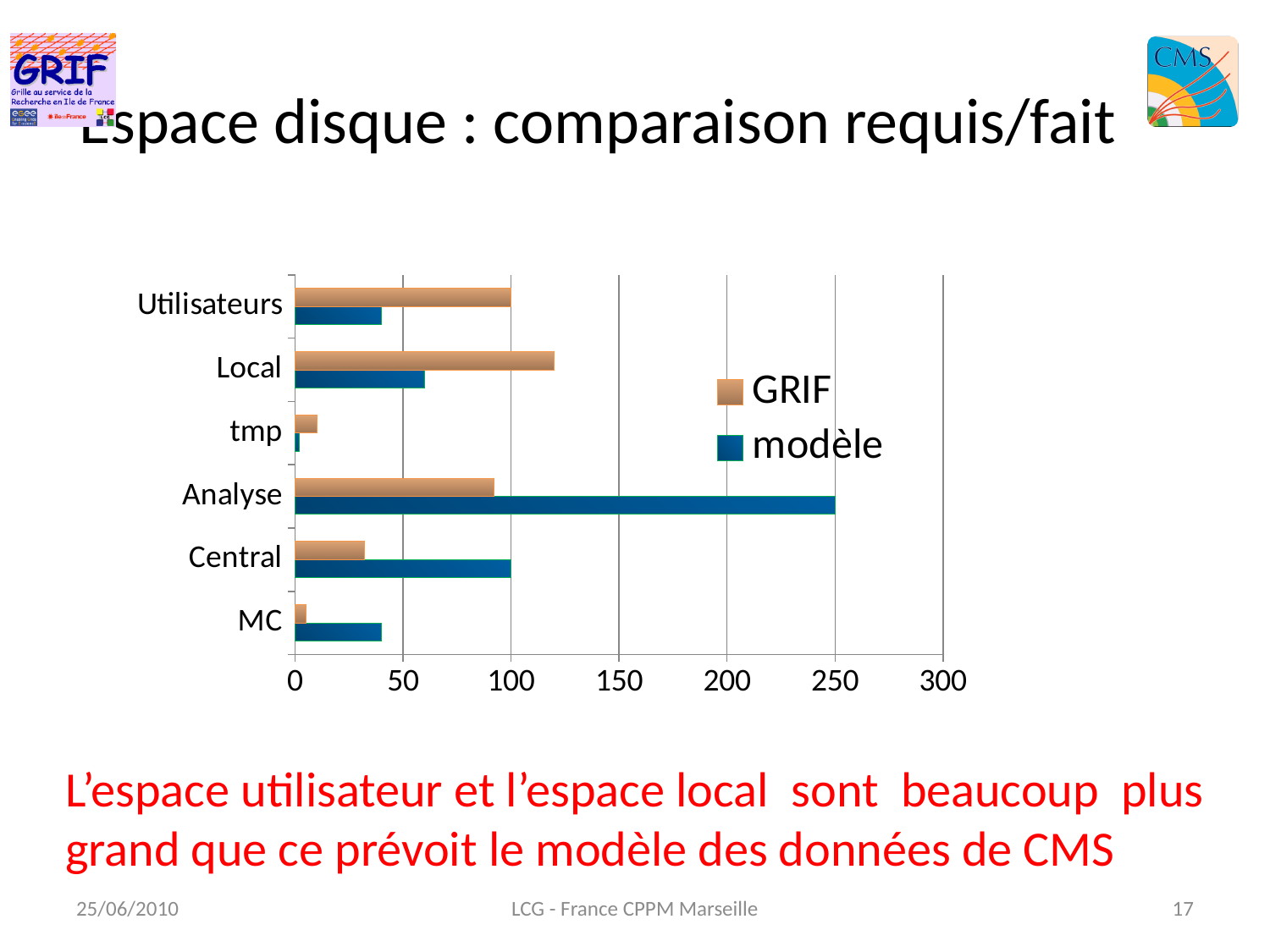
How many series does the legend list? 2 What are the two series names shown in the legend? GRIF and modèle Is the GRIF value for MC greater or less than 50? less Which category has the highest value for the GRIF series? Local For Utilisateurs, which series has the larger value, GRIF or modèle? GRIF Is the GRIF value for Local greater or less than 100? greater Which category has the highest value for the modèle series? Analyse How many categories are plotted on the chart? 6 For Central, which series has the larger value, GRIF or modèle? modèle Which category has the lowest value for the modèle series? tmp What kind of chart is shown on the slide? bar chart What is the modèle value for Analyse? 250